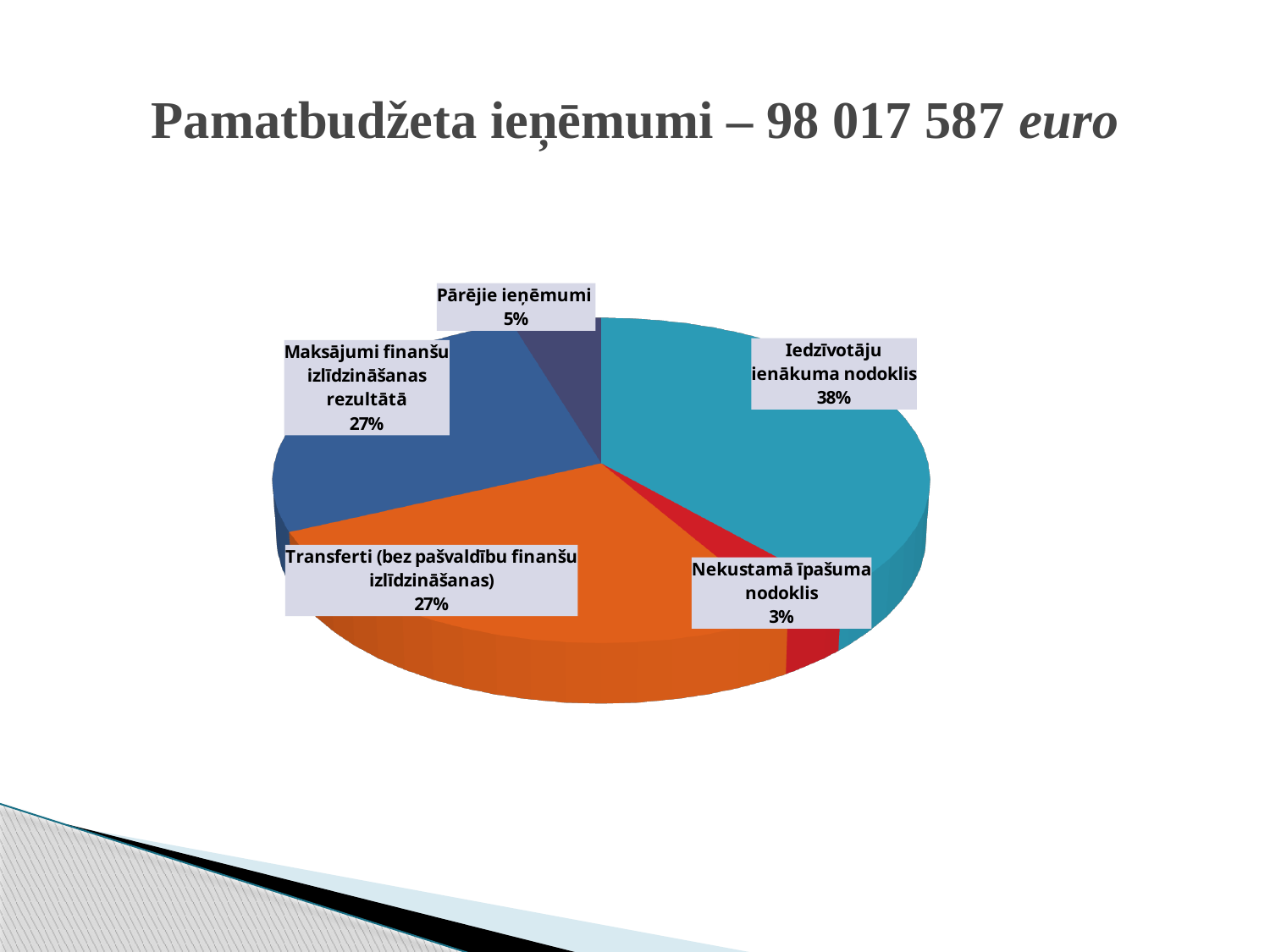
What is the difference in percentage points between Iedzīvotāju ienākuma nodoklis and Transferti (bez pašvaldību finanšu izlīdzināšanas)? 11 Which category has the largest slice of the pie? Iedzīvotāju ienākuma nodoklis What share of the pie does Pārējie ieņēmumi represent? 5% Which category has the smallest slice of the pie? Nekustamā īpašuma nodoklis What share of the pie does Iedzīvotāju ienākuma nodoklis represent? 38% What colour is the slice for Transferti (bez pašvaldību finanšu izlīdzināšanas)? Orange How many categories are shown in the pie chart? 5 What kind of chart is shown on the slide? Pie chart What share of the pie does Nekustamā īpašuma nodoklis represent? 3% Which is larger: Pārējie ieņēmumi or Nekustamā īpašuma nodoklis? Pārējie ieņēmumi What total amount of Pamatbudžeta ieņēmumi is stated in the slide title? 98 017 587 euro